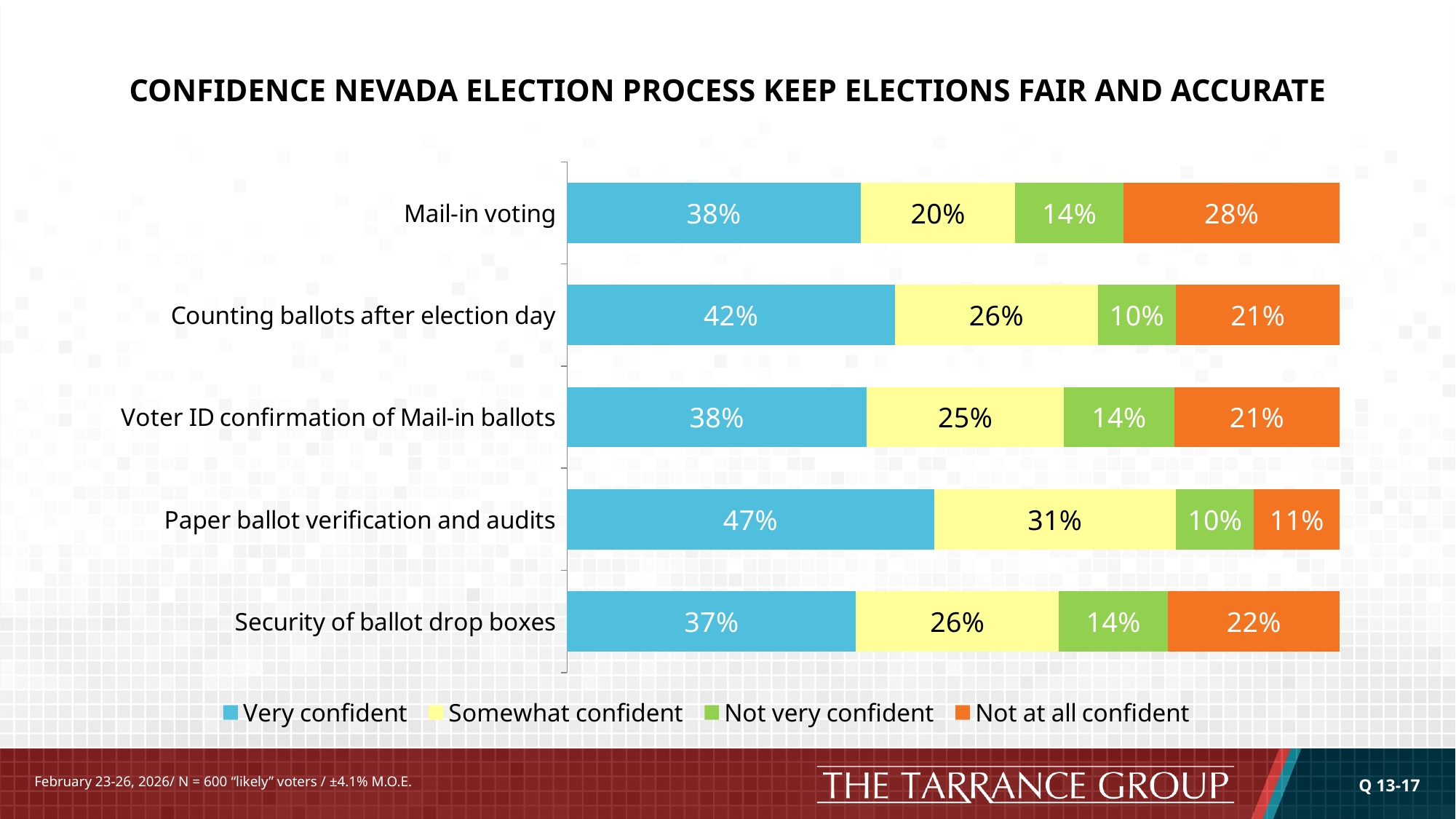
How many categories are shown in the chart? 5 Which category has the highest share of very confident respondents? Paper ballot verification and audits What is the difference between the very confident shares for paper ballot verification and audits and mail-in voting? 9 percentage points What percentage of respondents are not very confident in security of ballot drop boxes? 14% What percentage of respondents are very confident in mail-in voting? 38% What percentage of respondents are not at all confident in paper ballot verification and audits? 11% How many series does the legend list? 4 Which category has the lowest share of very confident respondents? Security of ballot drop boxes What percentage of respondents are somewhat confident in counting ballots after election day? 26% What kind of chart is shown on the slide? Stacked bar chart Which is larger: the not at all confident share for mail-in voting or for voter ID confirmation of mail-in ballots? Mail-in voting Which category has the highest share of not at all confident respondents? Mail-in voting